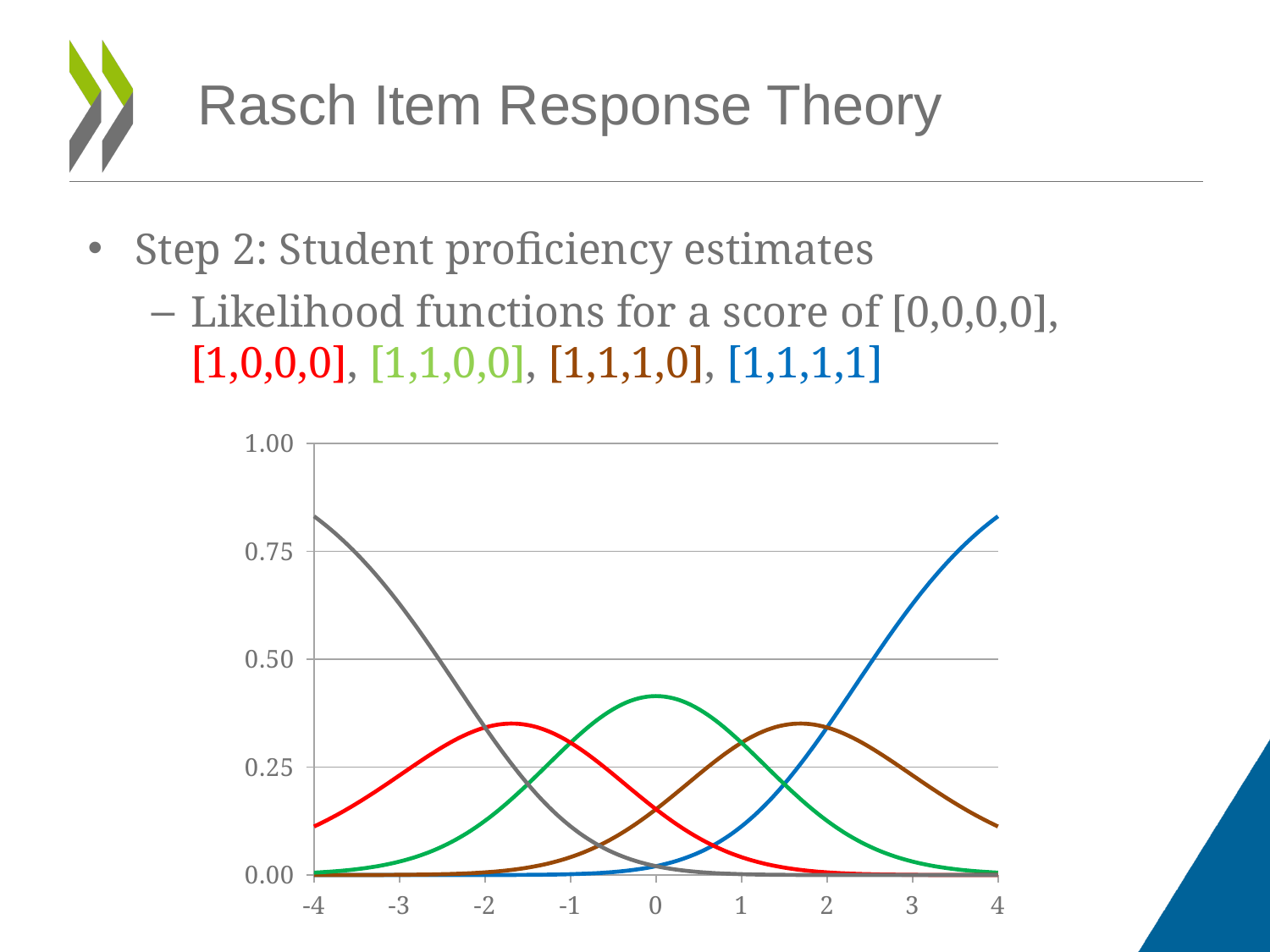
Is the peak of the green curve (score [1,1,0,0]) greater or less than 0.50? less Does the grey curve (score [0,0,0,0]) rise or fall as x increases from -4 to 4? fall How many tick labels are shown on the x axis of the chart? 9 Which curve has the highest value at x = 4? blue curve ([1,1,1,1]) Which peaks higher, the green curve (score [1,1,0,0]) or the red curve (score [1,0,0,0])? green curve Is the value of the grey curve (score [0,0,0,0]) at x = -4 greater or less than 0.75? greater Is the peak of the red curve (score [1,0,0,0]) greater or less than 0.25? greater How many likelihood curves are plotted on the chart? 5 What is the highest value labelled on the y axis of the chart? 1.00 What kind of chart is shown on the slide? line chart Does the blue curve (score [1,1,1,1]) rise or fall as x increases from -4 to 4? rise